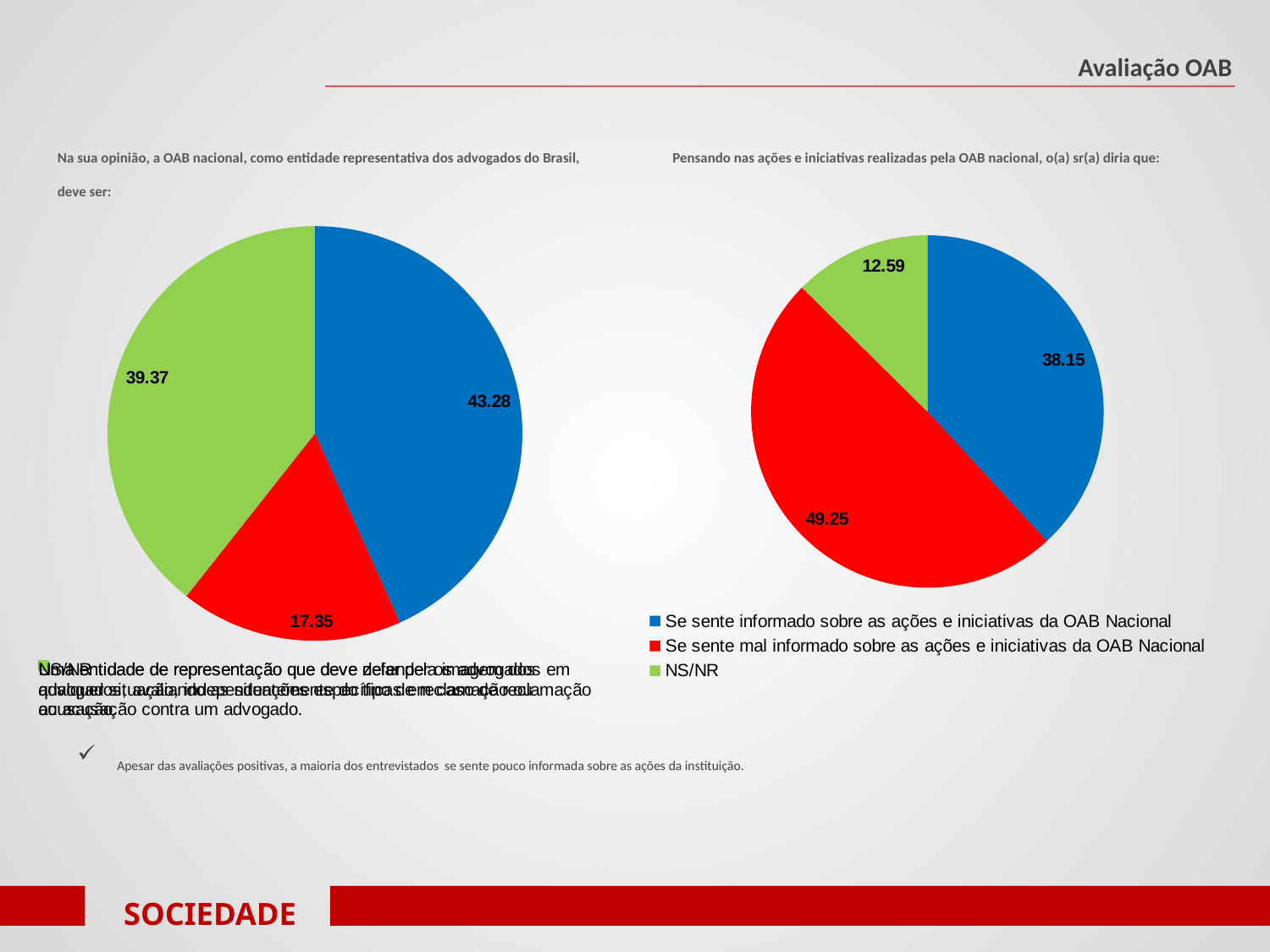
In the right-hand pie chart, what is the value for 'Se sente informado sobre as ações e iniciativas da OAB Nacional'? 38.15 In the left-hand pie chart, what is the value shown on the green slice? 39.37 In the left-hand pie chart, what is the value shown on the red slice? 17.35 In the right-hand pie chart, what is the difference between the 'Se sente mal informado' value and the 'Se sente informado' value? 11.10 In the left-hand pie chart, what is the value shown on the blue slice? 43.28 In the right-hand pie chart, which category has the smallest slice? NS/NR In the left-hand pie chart, which is larger, the blue slice or the green slice? the blue slice In the right-hand pie chart, what is the value for NS/NR? 12.59 In the right-hand pie chart, which category has the largest slice? Se sente mal informado sobre as ações e iniciativas da OAB Nacional What type of chart is used on the left side of the slide? pie chart How many entries does the legend of the right-hand pie chart list? 3 In the right-hand pie chart, what is the value for 'Se sente mal informado sobre as ações e iniciativas da OAB Nacional'? 49.25